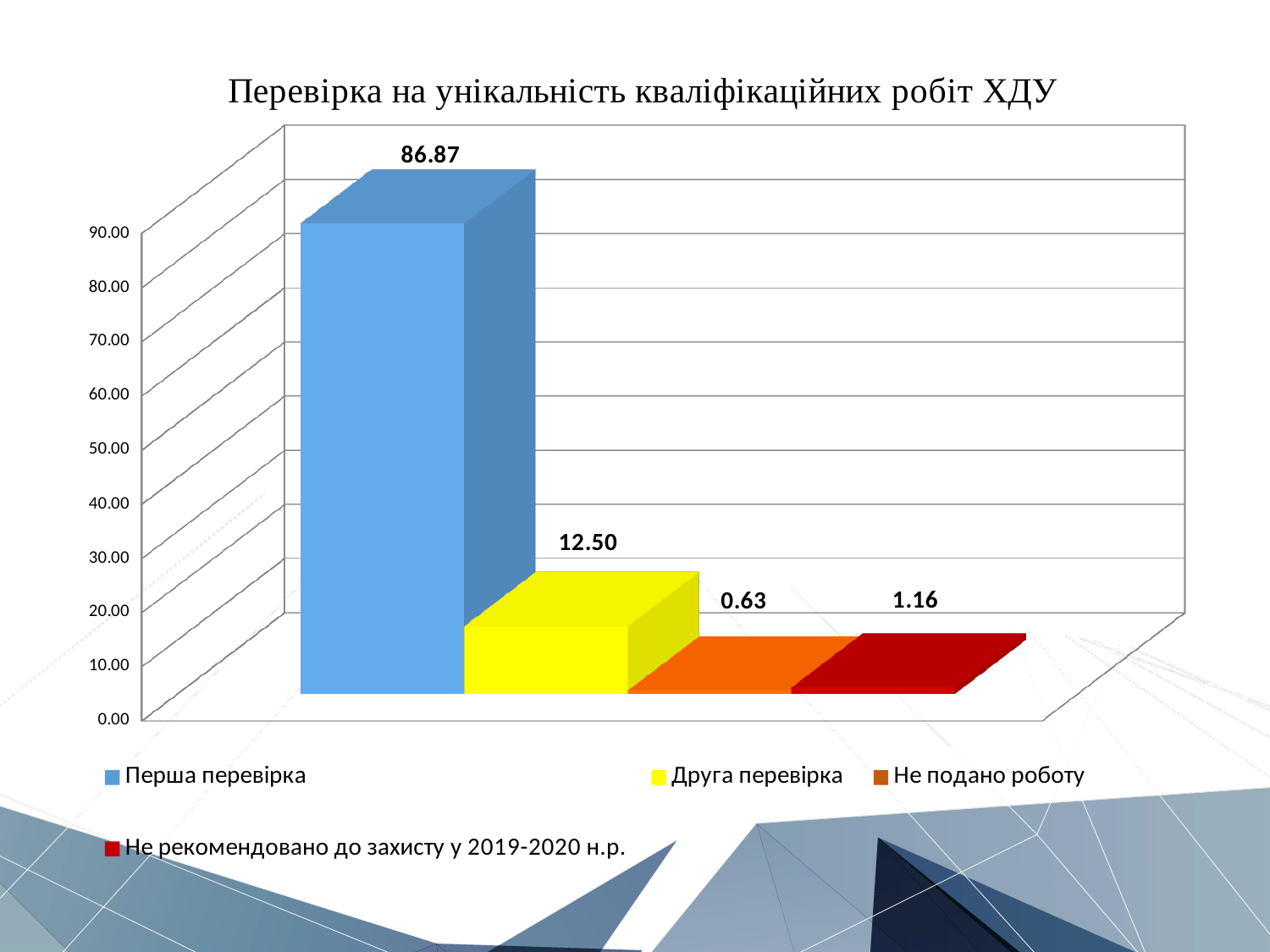
What is the difference between the values for Перша перевірка and Друга перевірка? 74.37 Is the value for Друга перевірка greater or less than 20.00? less Which is larger: the value for Не подано роботу or the value for Не рекомендовано до захисту у 2019-2020 н.р.? Не рекомендовано до захисту у 2019-2020 н.р. What kind of chart is shown on the slide? bar chart How many series does the legend list? 4 What is the title of the chart? Перевірка на унікальність кваліфікаційних робіт ХДУ Which series has the highest value? Перша перевірка What is the value for Перша перевірка? 86.87 What is the value for Друга перевірка? 12.50 Which series has the lowest value? Не подано роботу What is the value for Не рекомендовано до захисту у 2019-2020 н.р.? 1.16 What is the value for Не подано роботу? 0.63